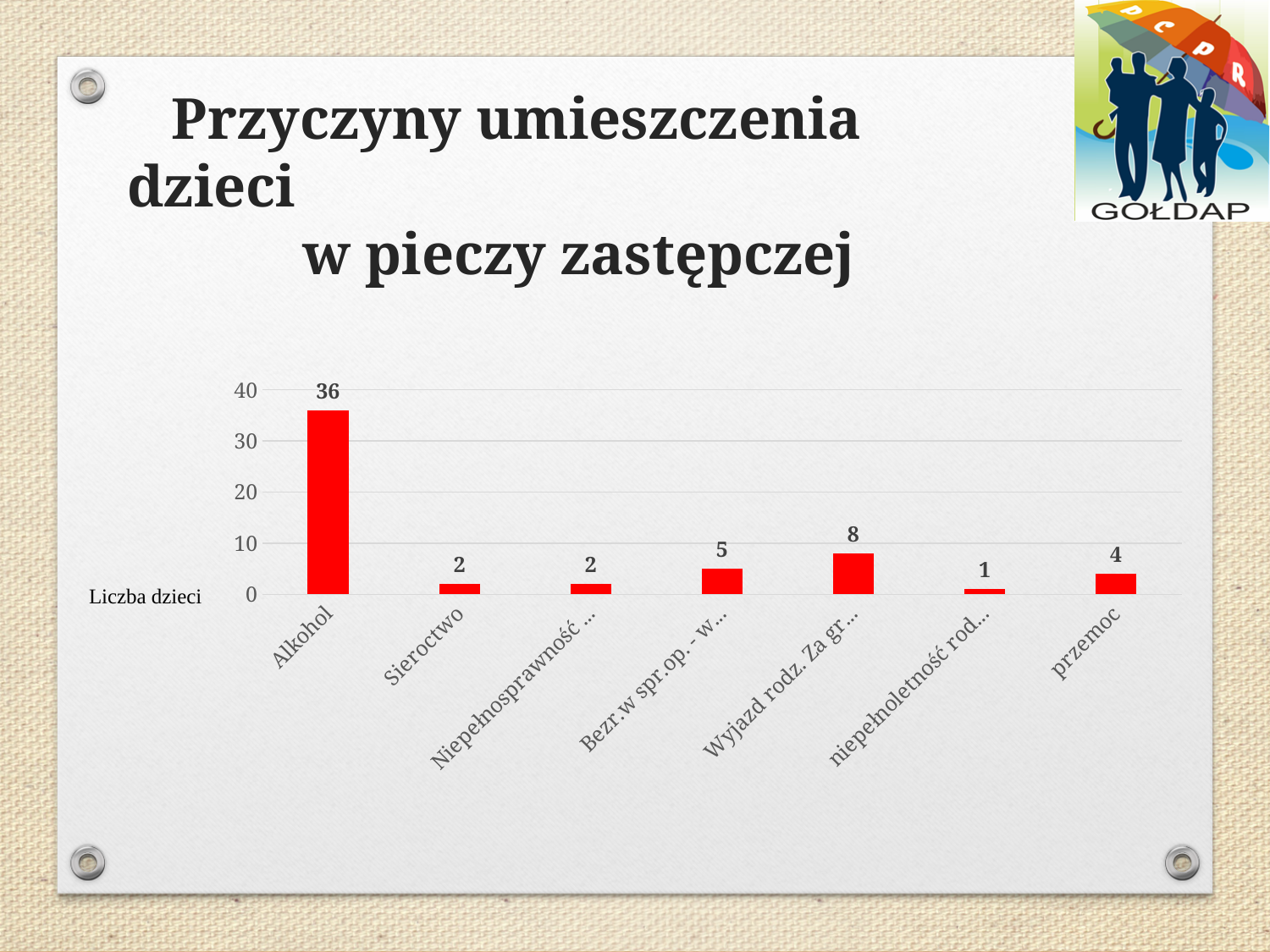
What is the value for przemoc? 4 Which category has the lowest value? niepełnoletność rod... What is the difference between the values for Alkohol and przemoc? 32 Is the value for Alkohol greater or less than 30? greater Which is larger, the value for Sieroctwo or the value for przemoc? przemoc How many categories are shown on the x axis? 7 What kind of chart is shown on the slide? bar chart Which category has the highest value? Alkohol What colour are the bars in the chart? red What is the value for Alkohol? 36 What is the value for Sieroctwo? 2 What is the label shown next to the vertical axis of the chart? Liczba dzieci